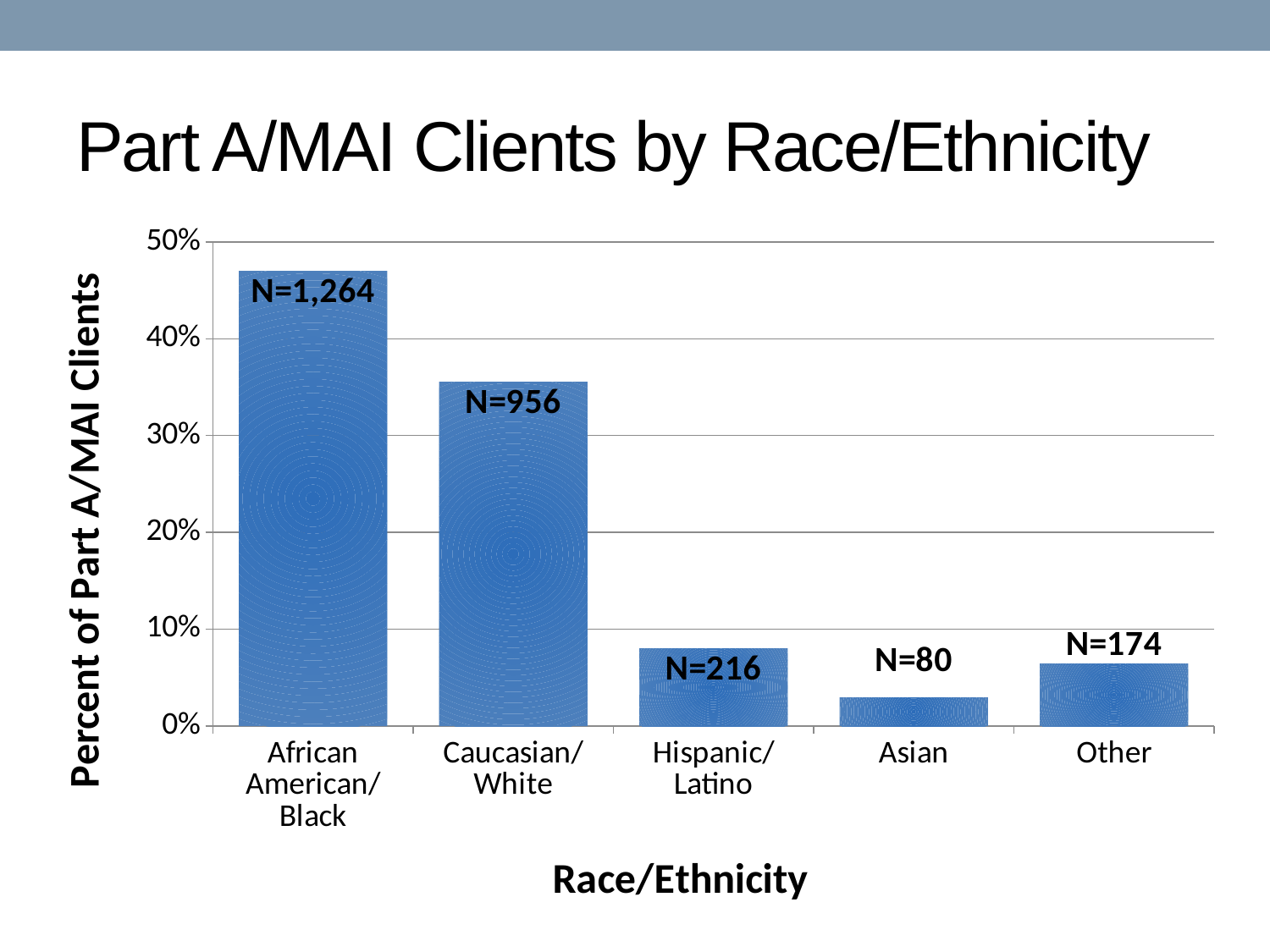
Which race/ethnicity category has the highest percent of Part A/MAI clients? African American/Black How many race/ethnicity categories are shown on the x axis? 5 What is the N label shown on the bar for Caucasian/White? N=956 What kind of chart is shown on the slide? bar chart Which race/ethnicity category has the lowest percent of Part A/MAI clients? Asian What is the N label shown on the bar for Asian? N=80 What is the N label shown on the bar for Hispanic/Latino? N=216 What is the N label shown on the bar for Other? N=174 What is the title of the chart on the slide? Part A/MAI Clients by Race/Ethnicity Is the percent of Part A/MAI clients for Hispanic/Latino greater or less than 10%? less Is the percent of Part A/MAI clients for Caucasian/White greater or less than 30%? greater What is the N label shown on the bar for African American/Black? N=1,264